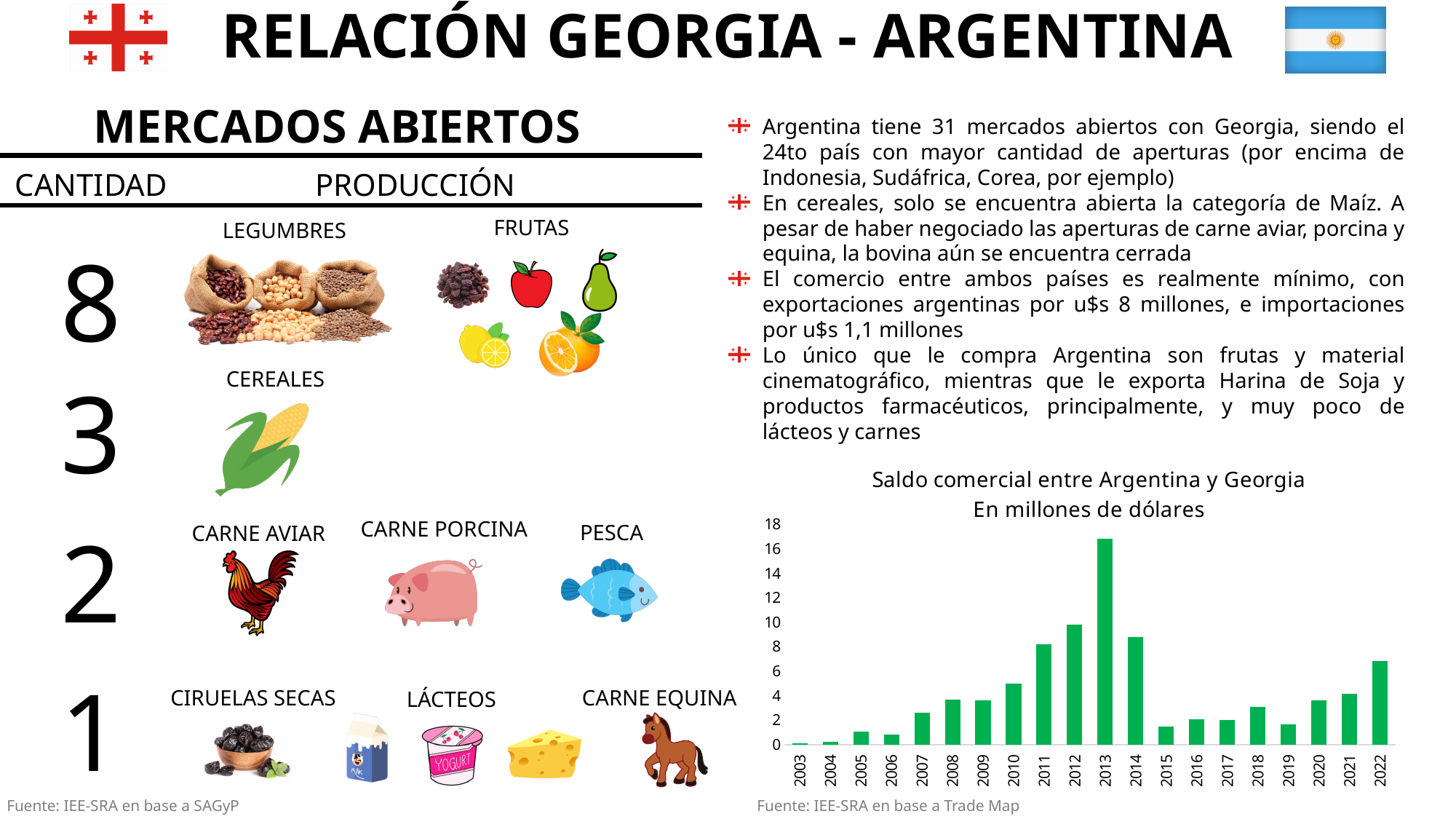
Which year has the larger value, 2011 or 2015? 2011 What is the title of the chart on the slide? Saldo comercial entre Argentina y Georgia In what units are the values of the chart expressed, according to its subtitle? En millones de dólares Is the value for 2010 greater or less than 6? less Is the value for 2015 greater or less than 2? less What kind of chart is shown on the slide? bar chart Which year has the larger value, 2021 or 2022? 2022 Which year has the highest value in the chart? 2013 Do the values rise or fall from 2010 to 2013? rise Is the value for 2013 greater or less than 16? greater How many years are plotted on the x axis of the chart? 20